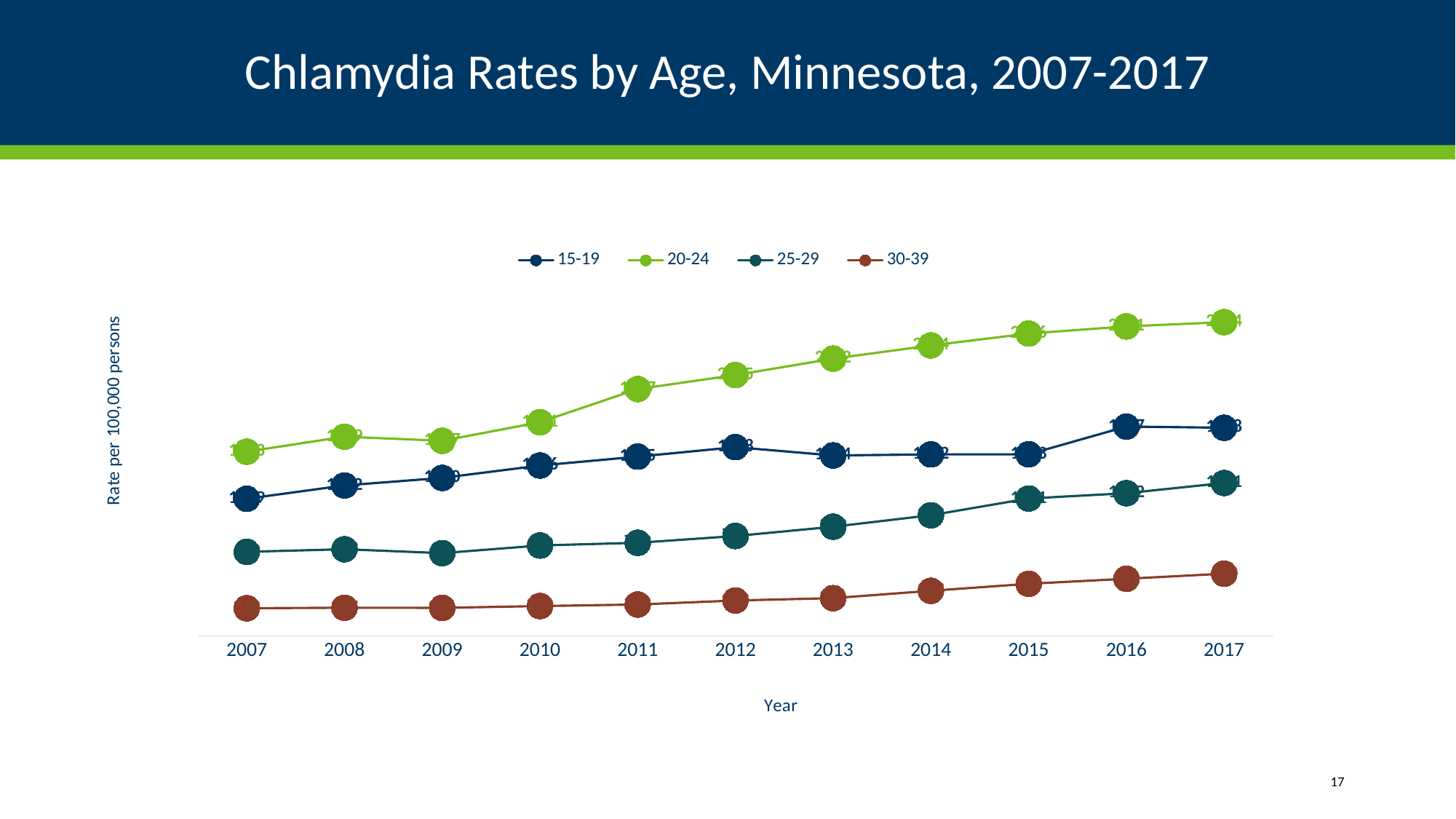
How many series does the legend list? 4 In 2012, which is larger: the rate for 15-19 or the rate for 25-29? 15-19 Does the rate for the 30-39 age group generally rise or fall from 2007 to 2017? rise Which age group has the lowest rate in 2017? 30-39 Which age group has the lowest rate in 2007? 30-39 What is the title of the chart? Chlamydia Rates by Age, Minnesota, 2007-2017 Which age group has the highest rate in 2017? 20-24 What kind of chart is shown on the slide? line chart What is the label of the y axis? Rate per 100,000 persons Does the rate for the 20-24 age group generally rise or fall from 2007 to 2017? rise In 2010, which is larger: the rate for 20-24 or the rate for 15-19? 20-24 How many years are plotted along the x axis? 11